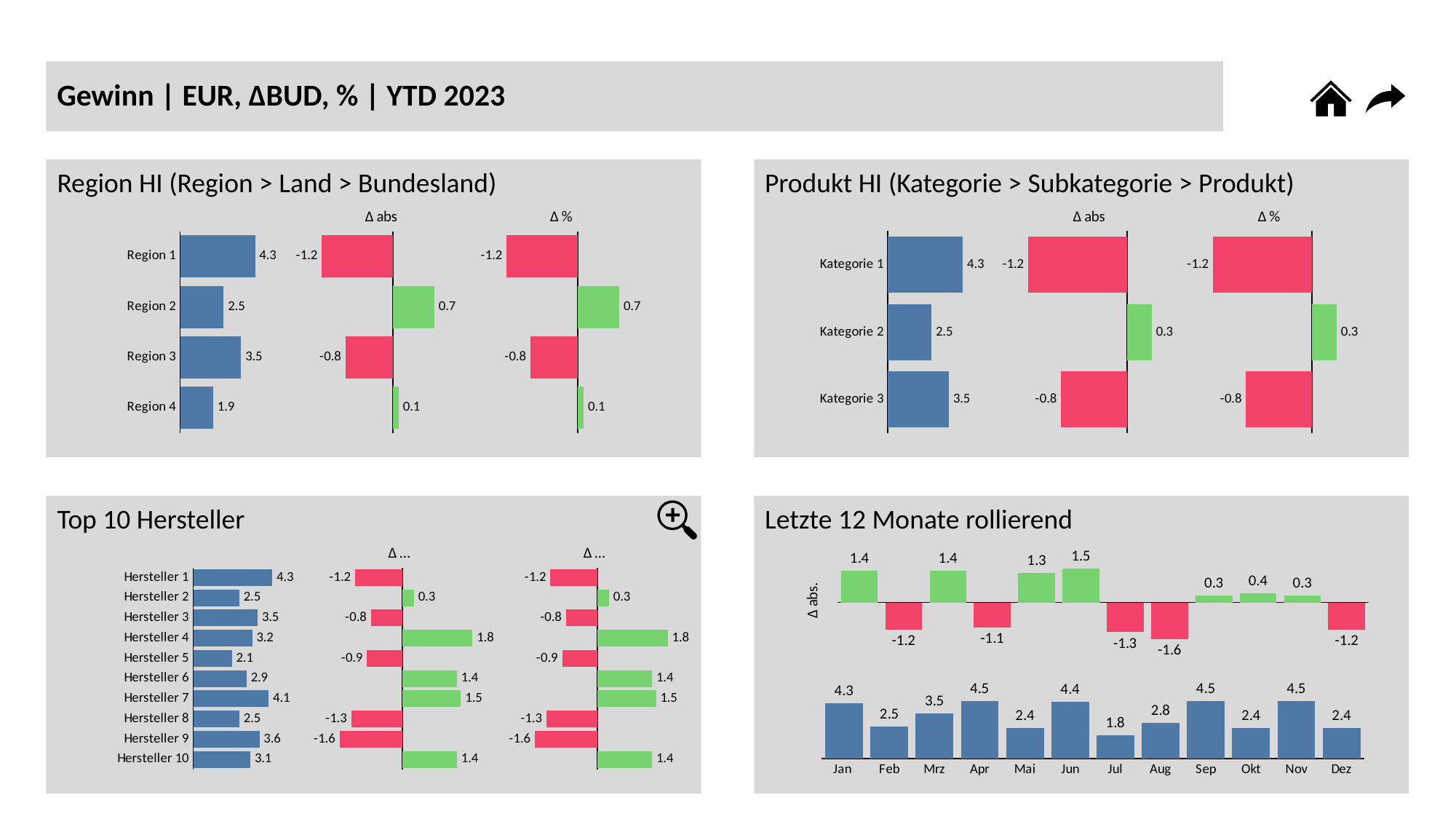
What kind of chart is used in the 'Letzte 12 Monate rollierend' panel? Bar chart In the 'Letzte 12 Monate rollierend' chart, which month has the lowest value in the lower bar chart? Jul In the 'Letzte 12 Monate rollierend' chart, which month has the lowest Δ abs value? Aug In the 'Produkt HI' chart, how many categories are shown? 3 In the 'Region HI' chart, which region has the highest value? Region 1 In the 'Top 10 Hersteller' chart, what is the value for Hersteller 7? 4.1 In the 'Top 10 Hersteller' chart, which Hersteller has the lowest value? Hersteller 5 In the 'Top 10 Hersteller' chart, what is the difference between the values for Hersteller 1 and Hersteller 9? 0.7 In the 'Region HI' chart, what is the Δ abs value for Region 2? 0.7 In the 'Produkt HI' chart, what is the Δ abs value for Kategorie 3? -0.8 In the 'Letzte 12 Monate rollierend' chart, what is the value for Aug in the lower bar chart? 2.8 In the 'Region HI' chart, what is the value for Region 3? 3.5